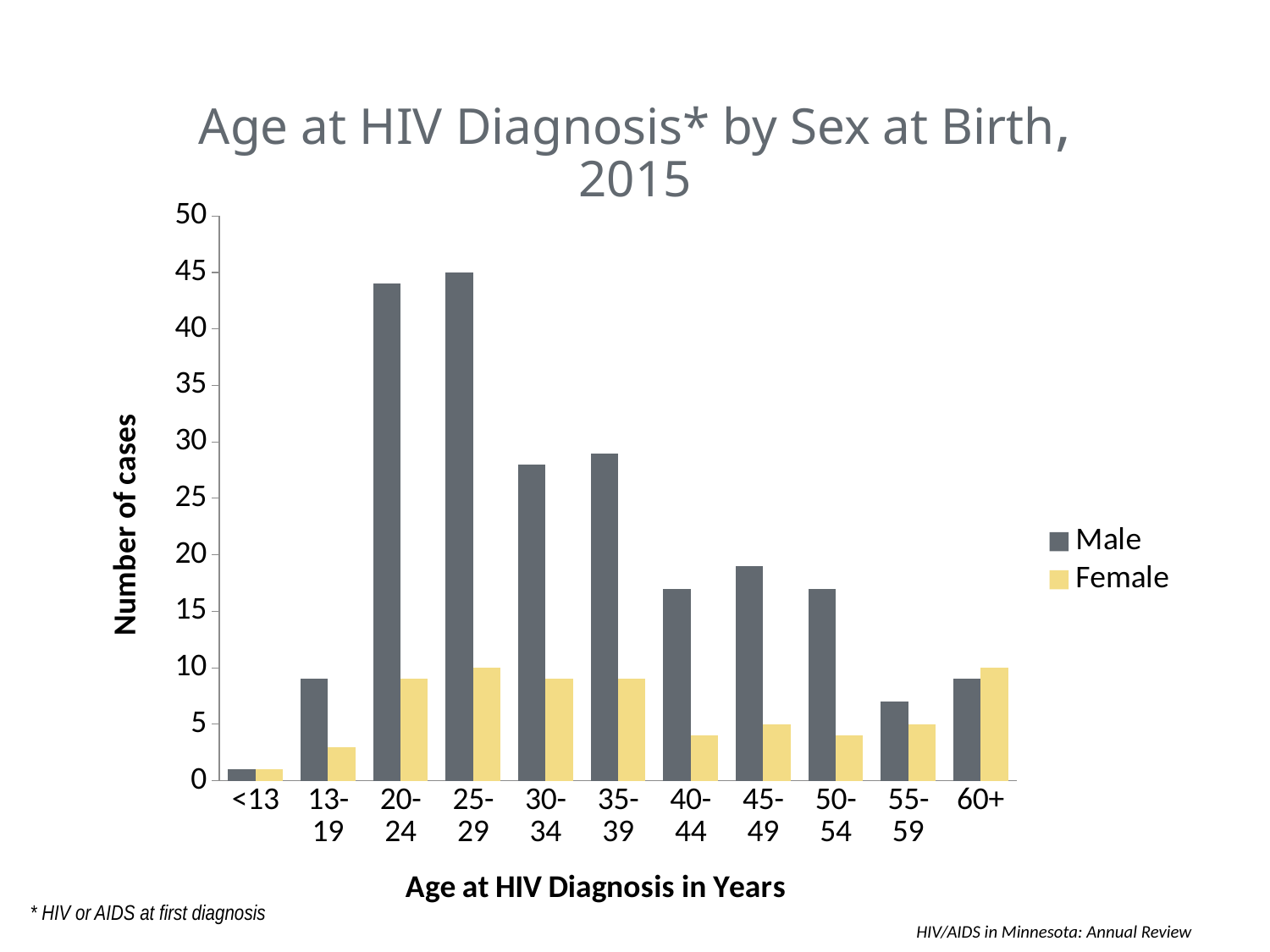
What is the number of Male cases for the 25-29 age group? 45 Is the number of Female cases for the 13-19 age group greater or less than 5? less What type of chart is shown on the slide? Bar chart For the 13-19 age group, which series has more cases, Male or Female? Male What is the label of the y axis? Number of cases Is the number of Male cases for the 20-24 age group greater or less than 40? greater Which age group has the lowest number of Male cases? <13 How many series does the legend list? 2 What is the number of Female cases for the 45-49 age group? 5 How many age categories are shown on the x axis? 11 What is the number of Female cases for the 25-29 age group? 10